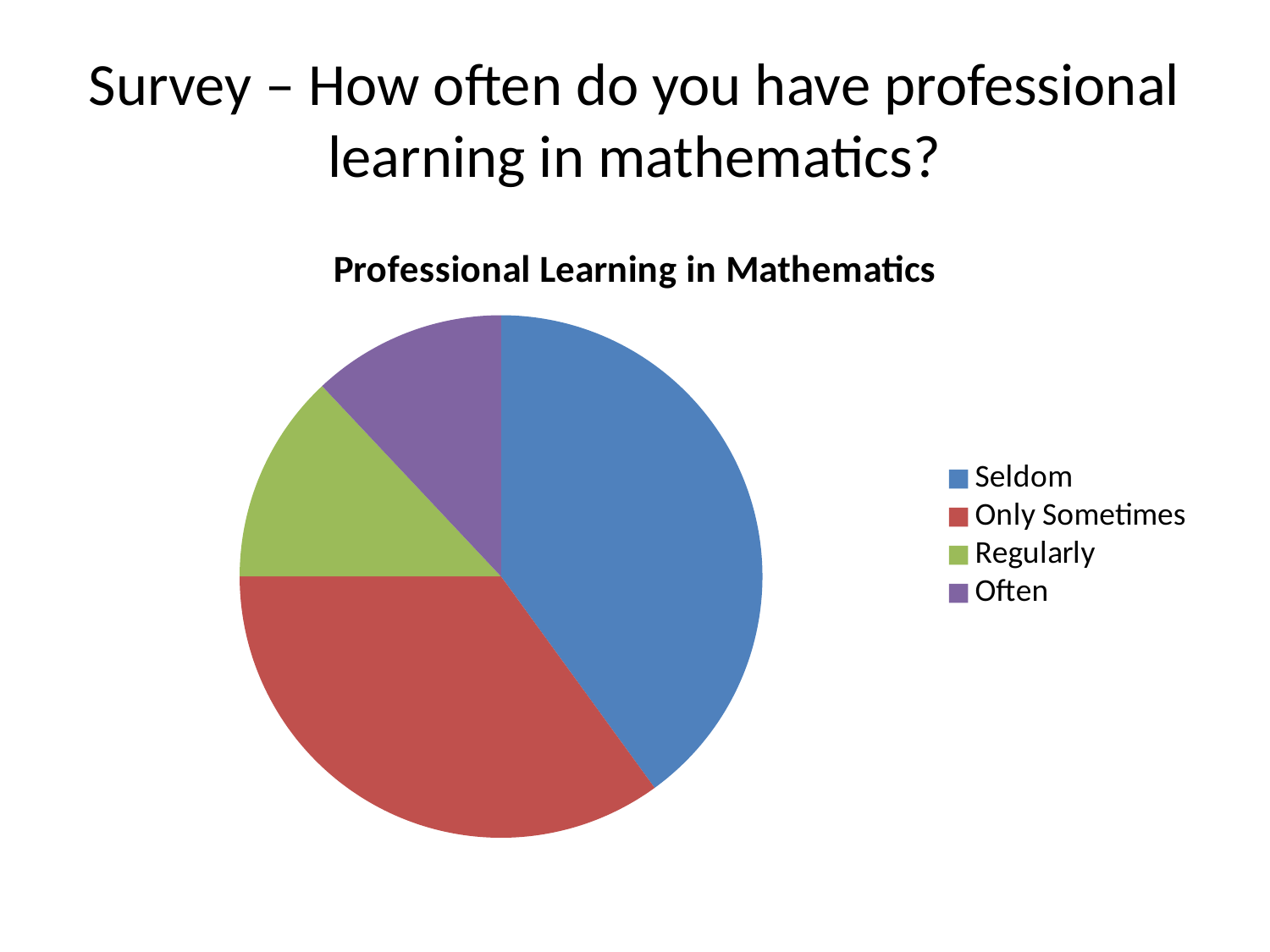
How many categories does the pie chart show? 4 Which category has the largest slice of the pie chart? Seldom What kind of chart is shown on the slide? pie chart What is the title of the chart? Professional Learning in Mathematics Which category is shown in blue in the pie chart? Seldom Which slice is larger, Only Sometimes or Often? Only Sometimes Which slice is larger, Seldom or Regularly? Seldom